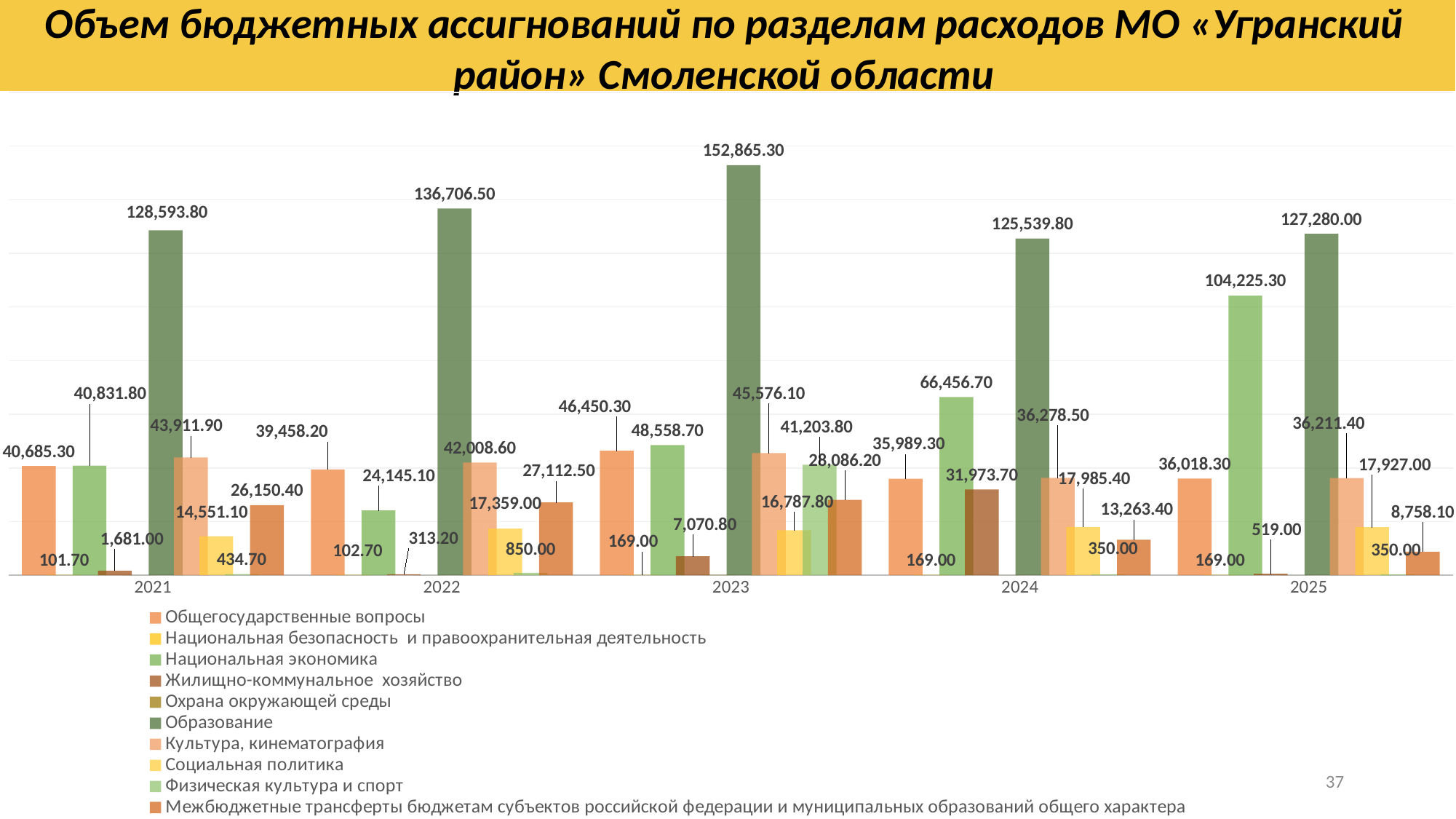
What is the value for Жилищно-коммунальное хозяйство in 2024? 31,973.70 What is the value for Межбюджетные трансферты in 2025? 8,758.10 In which year is the value for Образование the highest? 2023 What is the difference between the Образование values for 2023 and 2022? 16,158.80 How many years are shown on the x axis? 5 What kind of chart is shown on the slide? Bar chart In 2025, which is larger: Национальная экономика or Образование? Образование How many series does the legend list? 10 What is the value for Образование in 2023? 152,865.30 What is the difference between the Общегосударственные вопросы values for 2021 and 2022? 1,227.10 Does the value for Национальная экономика rise or fall from 2022 to 2025? Rises In which year is the value for Межбюджетные трансферты the lowest? 2025